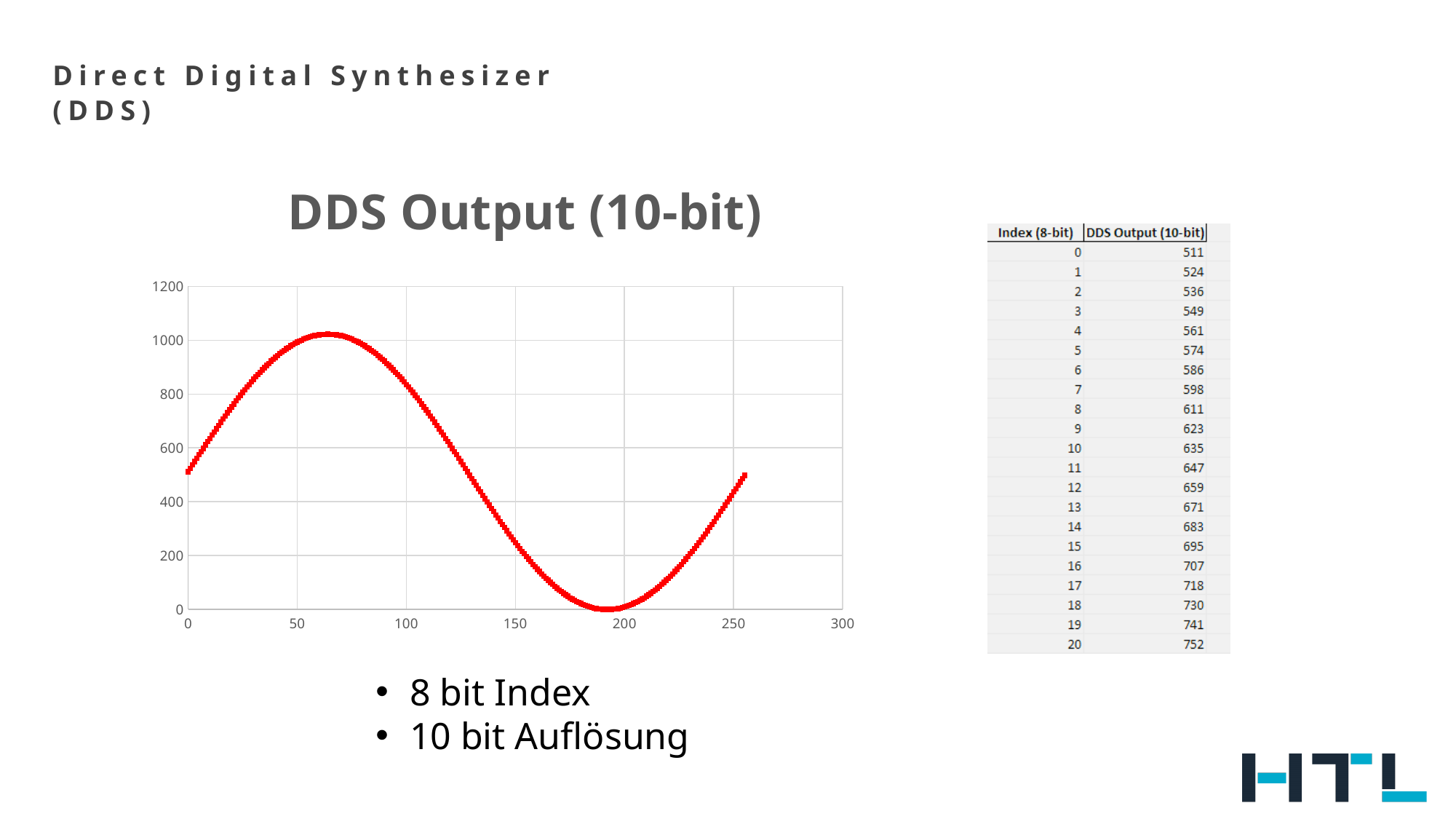
Between x = 100 and x = 200, do the plotted values rise or fall? fall What is the highest tick value shown on the y axis of the chart? 1200 Between x = 0 and x = 50, do the plotted values rise or fall? rise Is the value of the DDS output at x = 150 greater or less than 400? less What colour are the plotted points in the chart? Red According to the table on the slide, what is the DDS output at index 0? 511 Is the value of the DDS output at x = 200 greater or less than 200? less Which is larger, the DDS output at x = 50 or at x = 150? x = 50 Is the value of the DDS output at x = 100 greater or less than 600? greater What is the title of the chart? DDS Output (10-bit) According to the table on the slide, what is the DDS output at index 20? 752